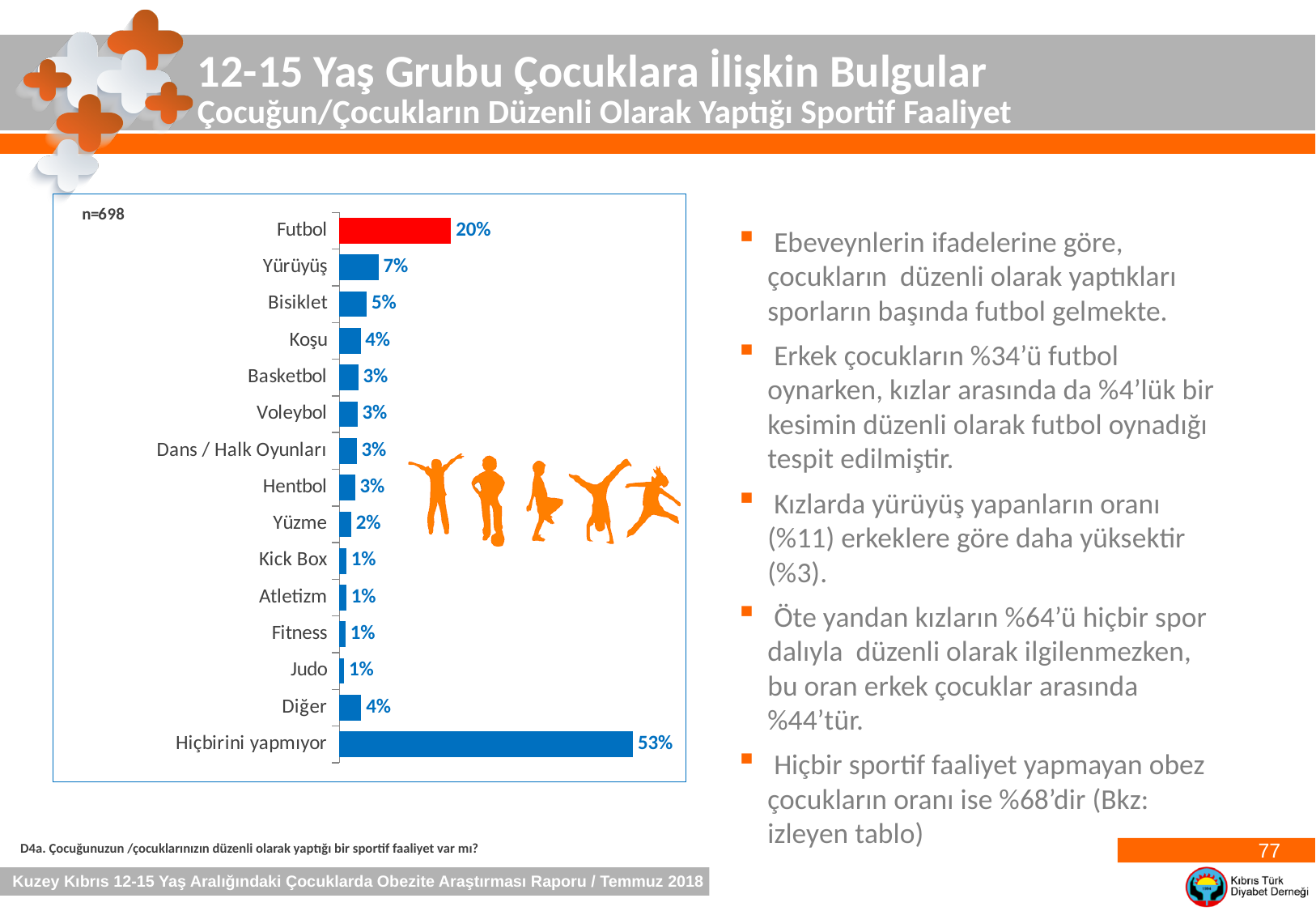
What is the value for Hiçbirini yapmıyor? 53% What is the value for Bisiklet? 5% What is the value for Yürüyüş? 7% Which is larger, the value for Koşu or the value for Basketbol? Koşu What is the value for Yüzme? 2% How many categories are shown in the chart? 15 Which category has the highest value? Hiçbirini yapmıyor What sample size (n) is shown on the chart? n=698 What is the value for Futbol? 20% What kind of chart is shown on the slide? Bar chart What is the difference between the values for Hiçbirini yapmıyor and Futbol? 33% What is the difference between the values for Futbol and Yürüyüş? 13%